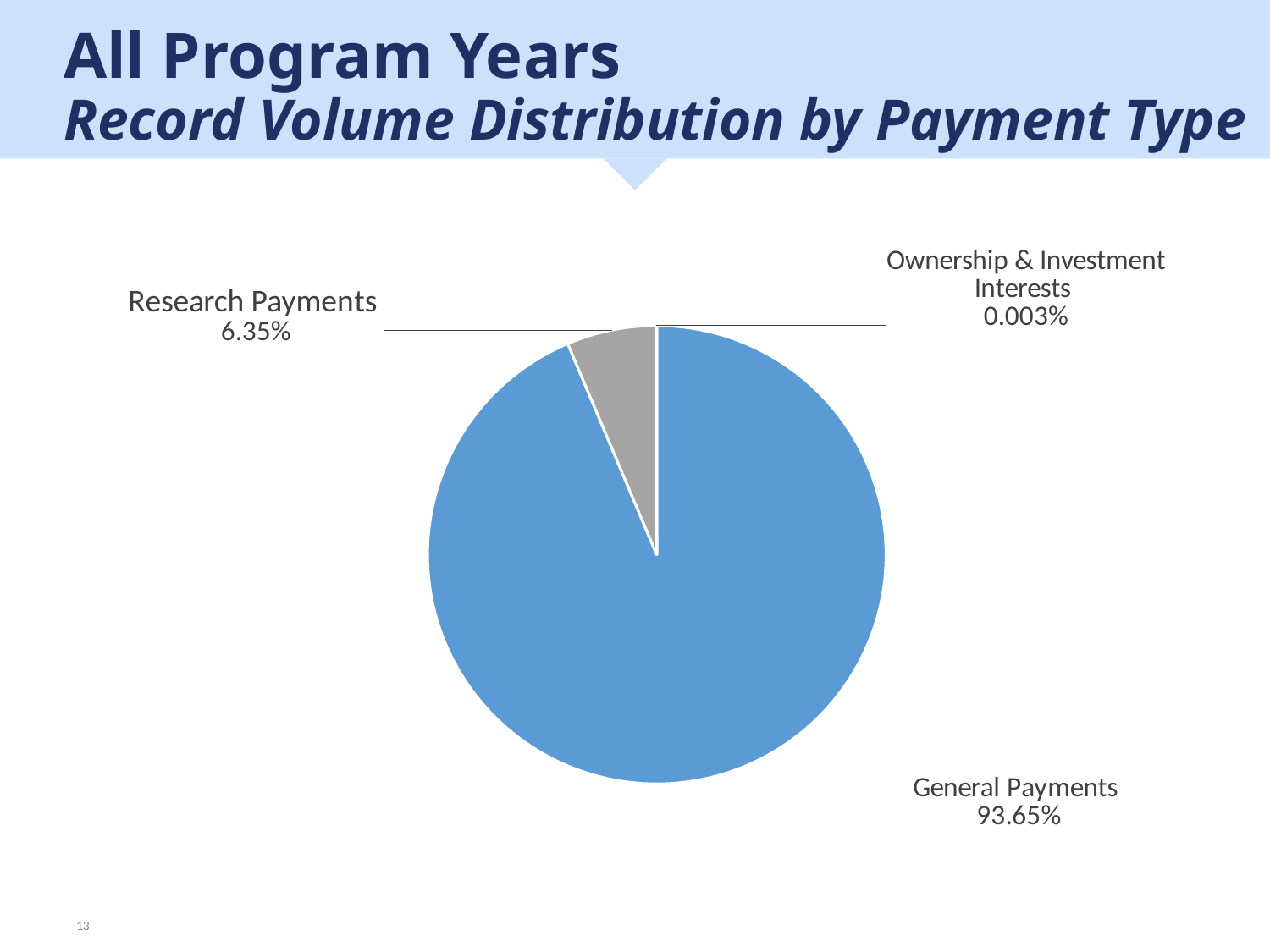
How many payment types are shown in the pie chart? 3 What share of record volume is Ownership & Investment Interests? 0.003% What kind of chart is shown on the slide? Pie chart What colour is the General Payments slice? Blue What is the title of the chart on the slide? All Program Years Record Volume Distribution by Payment Type Which payment type has the largest share of record volume? General Payments Which is larger, the share for Research Payments or the share for Ownership & Investment Interests? Research Payments Which payment type has the smallest share of record volume? Ownership & Investment Interests What share of record volume is General Payments? 93.65% What is the difference in percentage points between General Payments and Research Payments? 87.3 What share of record volume is Research Payments? 6.35%